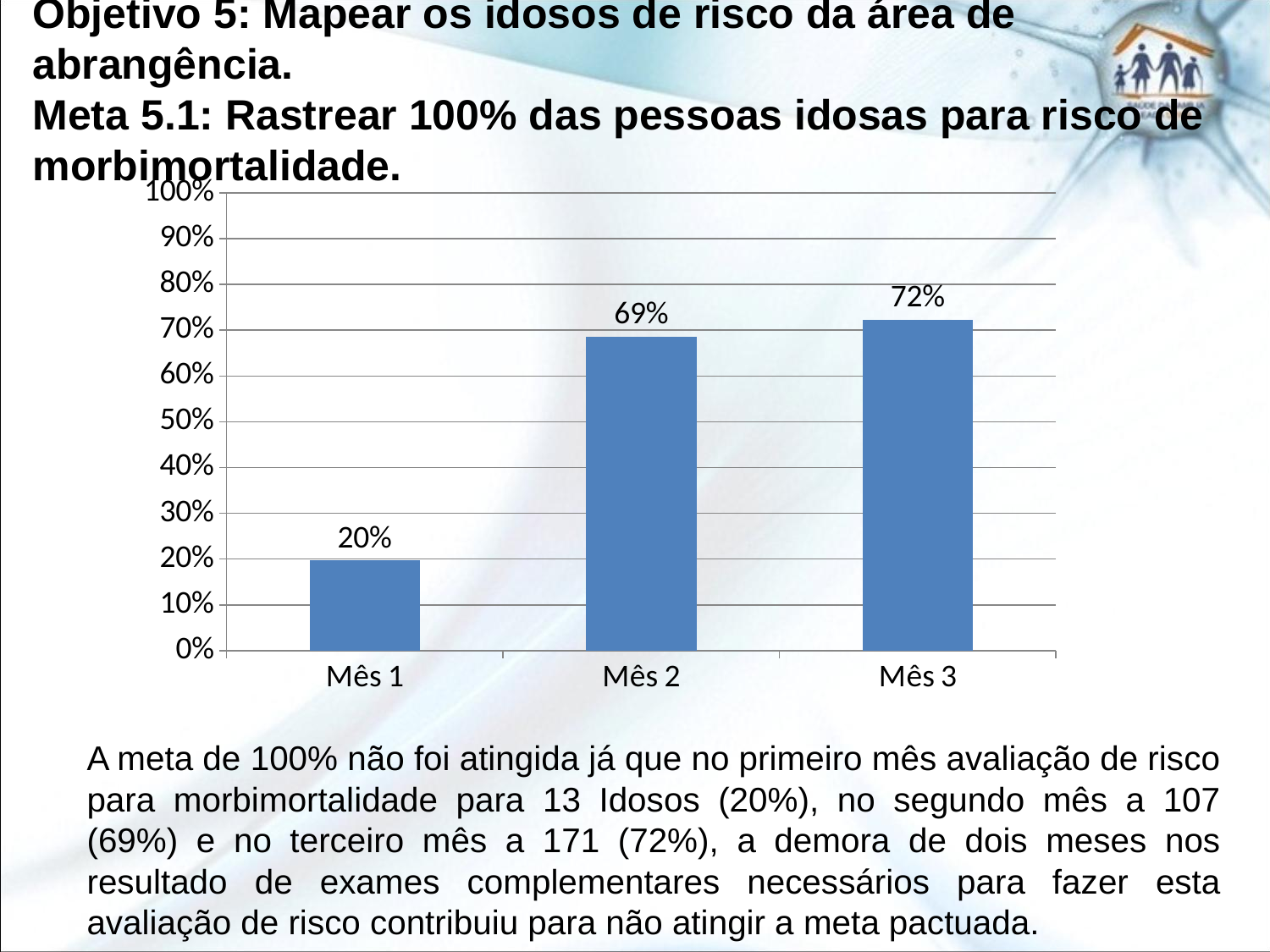
What is the difference between the values for Mês 3 and Mês 2? 3% What is the value for Mês 3? 72% Is the value for Mês 2 greater or less than 50%? greater Which is larger, the value for Mês 1 or the value for Mês 2? Mês 2 Which month has the highest value? Mês 3 What kind of chart is shown on the slide? bar chart What is the value for Mês 1? 20% What is the difference between the values for Mês 2 and Mês 1? 49% How many categories are shown on the x axis? 3 Do the values rise or fall from Mês 1 to Mês 3? rise What is the value for Mês 2? 69% Which month has the lowest value? Mês 1